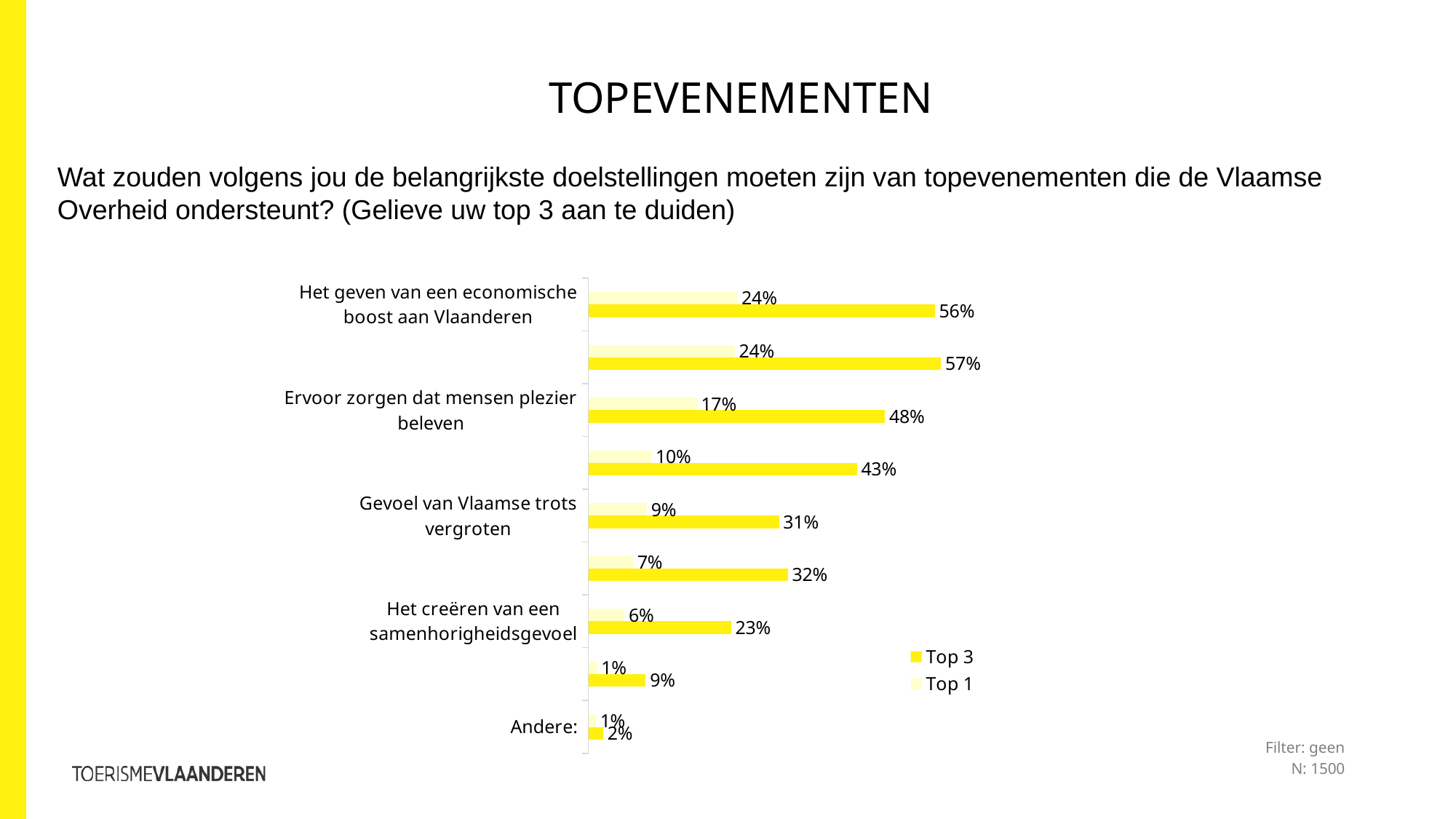
What is the difference between the Top 3 and Top 1 values for 'Ervoor zorgen dat mensen plezier beleven'? 31% Which labelled category has the lowest Top 3 value? Andere: Which has a larger Top 3 value: 'Gevoel van Vlaamse trots vergroten' or 'Het creëren van een samenhorigheidsgevoel'? Gevoel van Vlaamse trots vergroten How many series does the legend list? 2 What are the two series named in the legend? Top 3 and Top 1 What is the Top 3 value for 'Andere:'? 2% What is the Top 3 value for 'Het creëren van een samenhorigheidsgevoel'? 23% What is the Top 1 value for 'Gevoel van Vlaamse trots vergroten'? 9% What is the Top 1 value for 'Het geven van een economische boost aan Vlaanderen'? 24% What is the Top 3 value for 'Ervoor zorgen dat mensen plezier beleven'? 48% What kind of chart is shown on the slide? bar chart What is the Top 3 value for 'Het geven van een economische boost aan Vlaanderen'? 56%